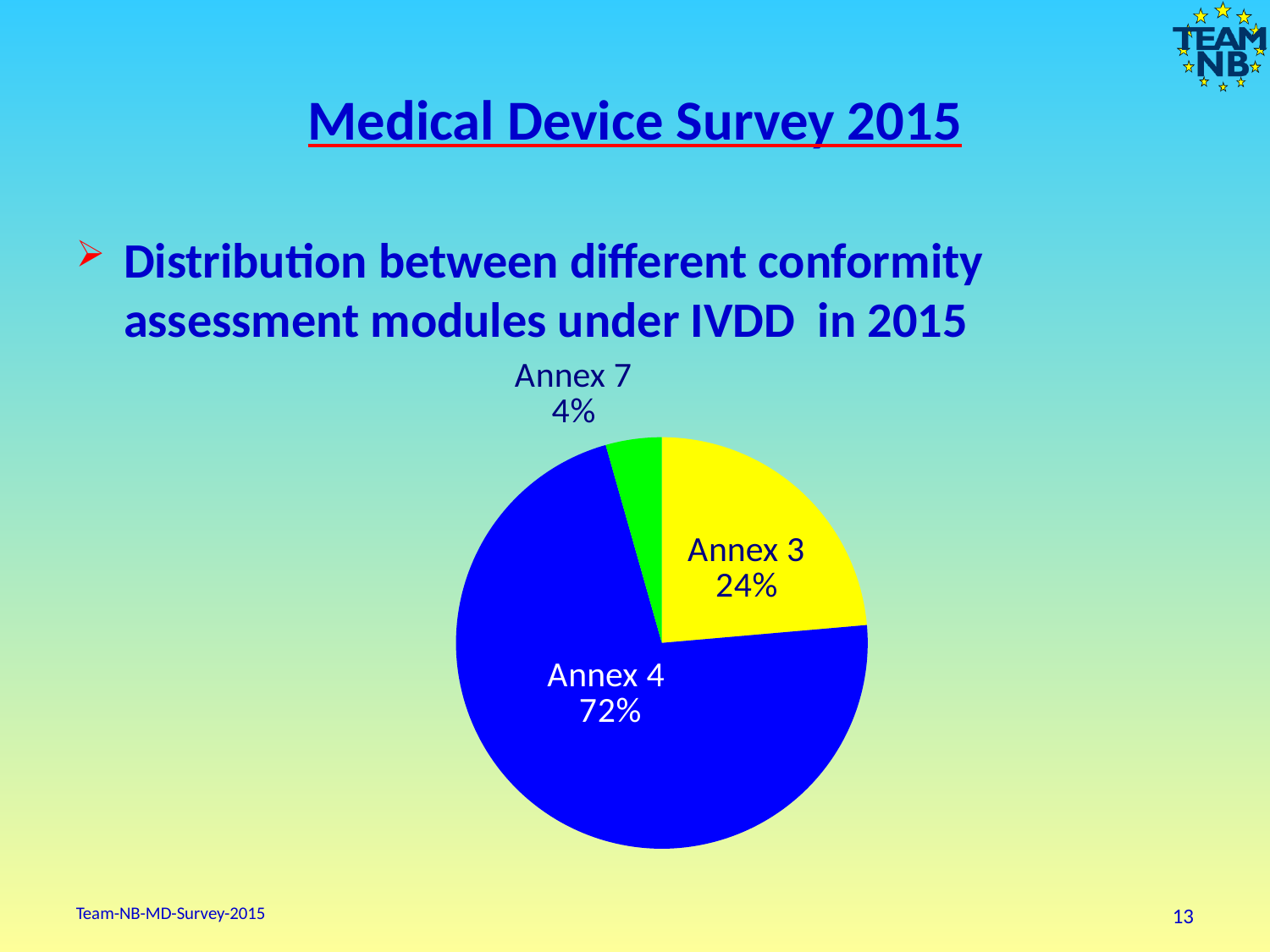
What colour is the Annex 3 slice? Yellow What share of the pie does Annex 4 represent? 72% What share of the pie does Annex 7 represent? 4% Which has a larger share, Annex 3 or Annex 7? Annex 3 Which annex has the smallest share of the pie? Annex 7 What share of the pie does Annex 3 represent? 24% Which annex has the largest share of the pie? Annex 4 What colour is the Annex 4 slice? Blue What is the difference in percentage points between the Annex 4 and Annex 3 shares? 48 What kind of chart is shown on the slide? Pie chart What is the difference in percentage points between the Annex 3 and Annex 7 shares? 20 How many slices does the pie chart have? 3